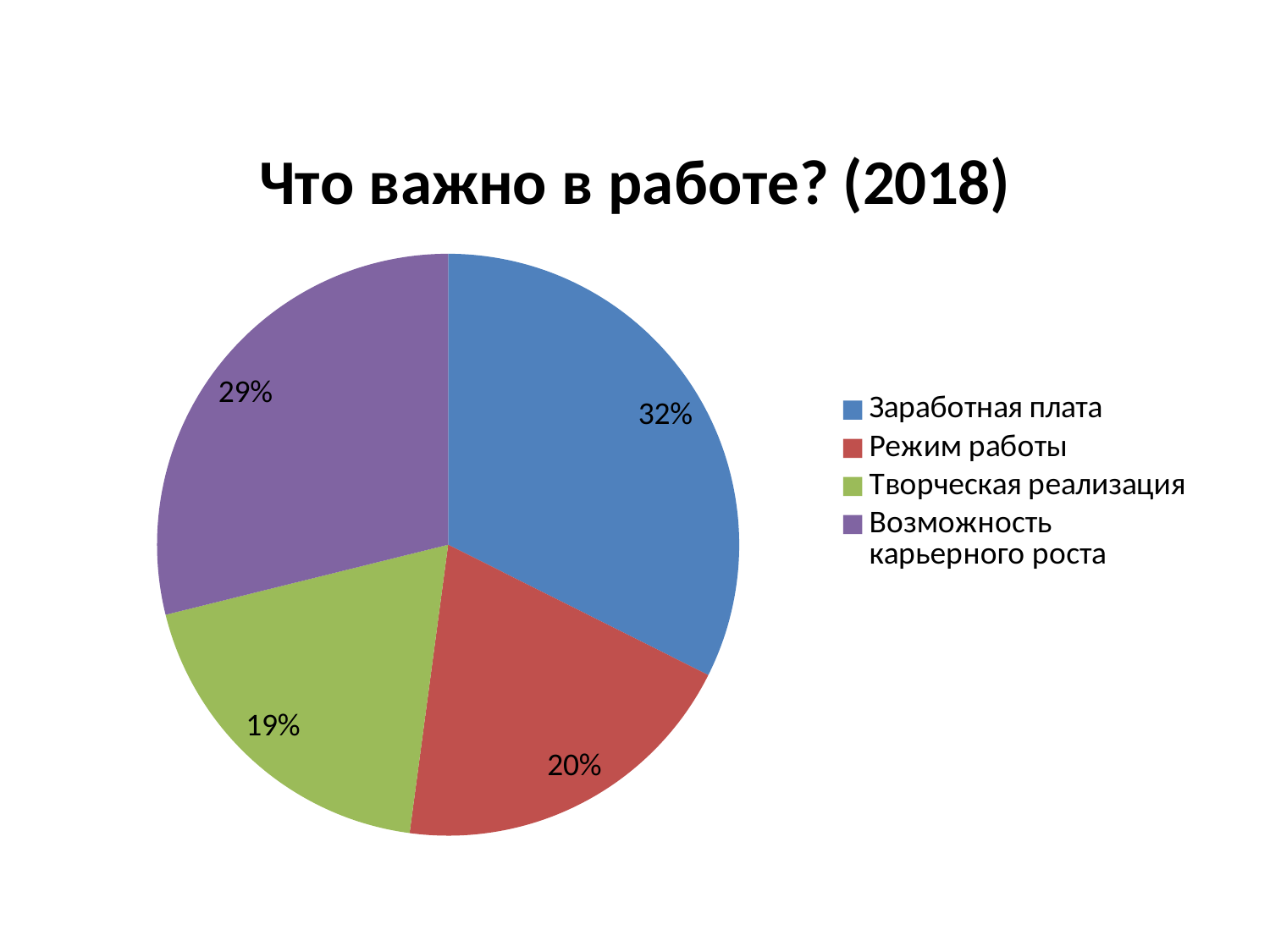
How many categories does the legend list? 4 What share of the pie does Возможность карьерного роста have? 29% Which category has the largest share of the pie? Заработная плата Which category has the smallest share of the pie? Творческая реализация What colour is the slice for Творческая реализация? green What is the title of the chart? Что важно в работе? (2018) What is the difference in percentage points between Заработная плата and Возможность карьерного роста? 3% What share of the pie does Заработная плата have? 32% What type of chart is shown on the slide? pie chart Which is larger: the share for Режим работы or the share for Возможность карьерного роста? Возможность карьерного роста What share of the pie does Творческая реализация have? 19%